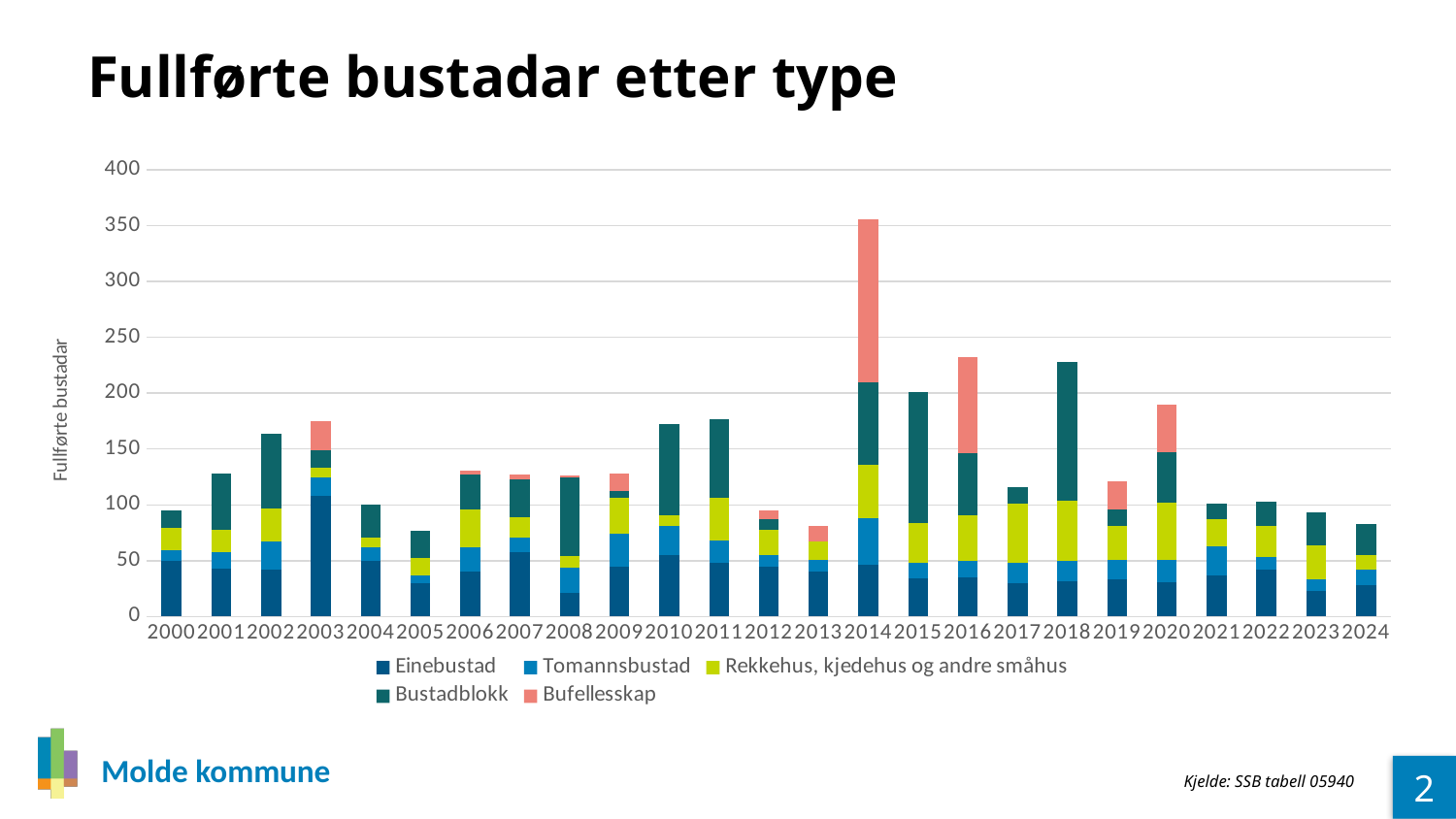
Is the total for 2014 greater or less than 300? greater Which year has the larger total, 2017 or 2018? 2018 Do the total bar heights rise or fall from 2022 to 2024? fall Which year has the larger total, 2014 or 2015? 2014 How many series does the legend list? 5 Is the total for 2018 greater or less than 200? greater Is the total for 2005 greater or less than 100? less How many years are shown along the x axis? 25 What is the title of the chart? Fullførte bustadar etter type What kind of chart is shown on the slide? Stacked bar chart Which year has the highest total of completed dwellings? 2014